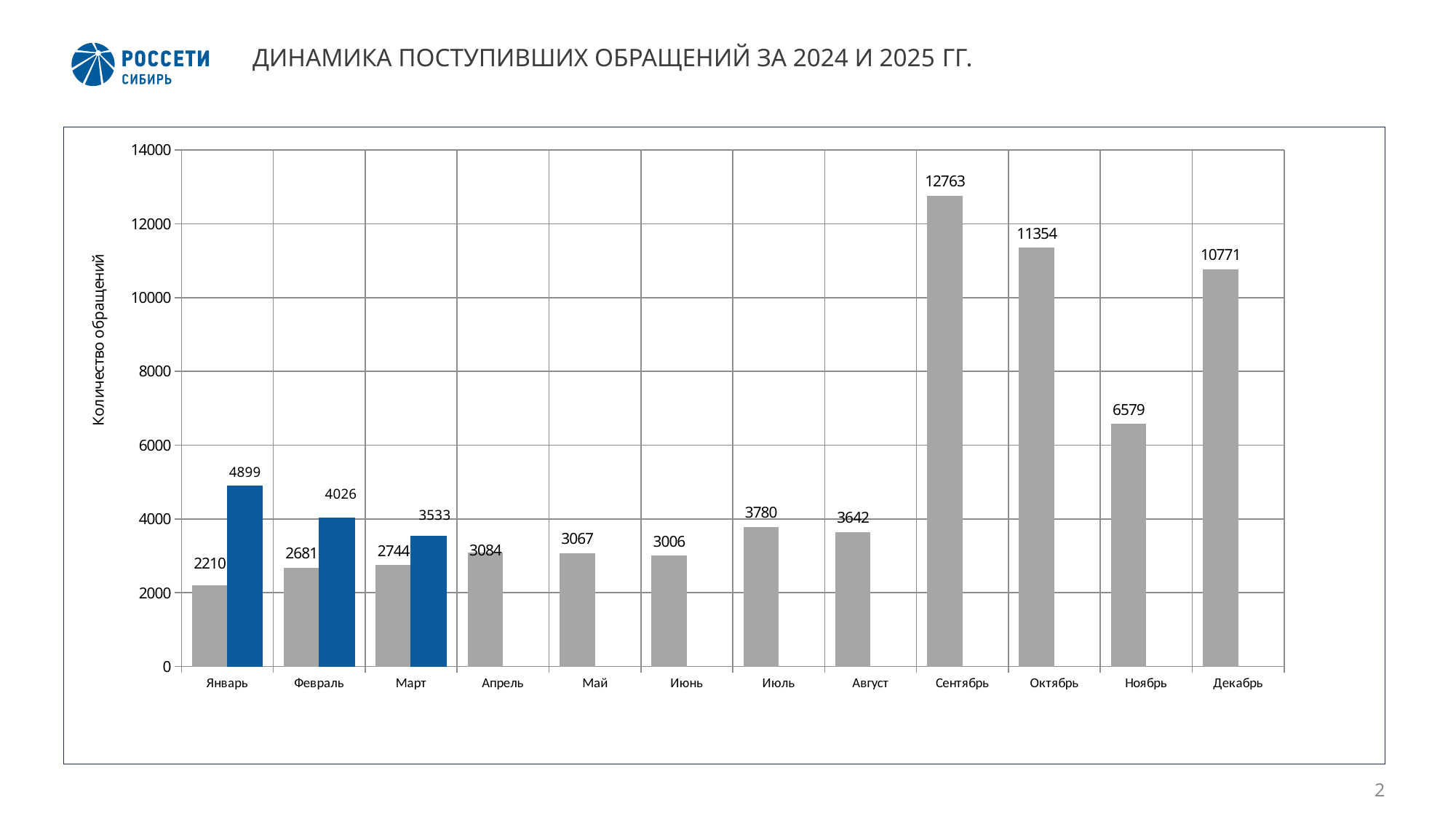
What is the value of the gray bar for Июль? 3780 Which month has the highest gray bar? Сентябрь What kind of chart is shown on the slide? bar chart Is the value for Ноябрь greater or less than 6000? greater Which month has the lowest gray bar? Январь Do the blue bars rise or fall from Январь to Март? fall What is the difference between the gray bars for Сентябрь and Октябрь? 1409 What is the value of the gray bar for Сентябрь? 12763 What is the value of the blue bar for Январь? 4899 Which gray bar is larger, Октябрь or Декабрь? Октябрь What is the difference between the blue bar and the gray bar for Январь? 2689 How many months are shown on the x axis? 12